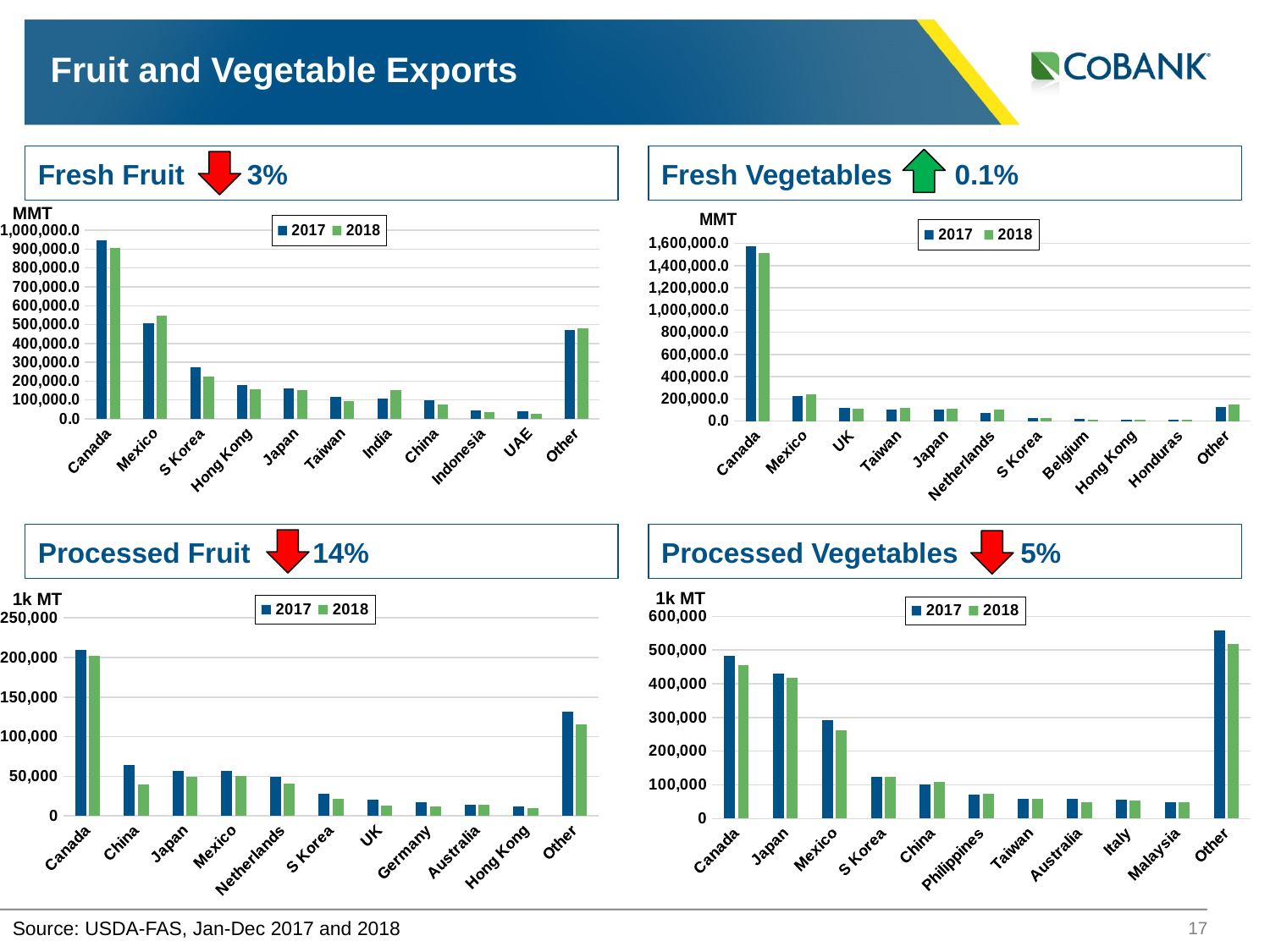
In the Processed Fruit chart, is the 2018 value for China greater or less than 50,000? less In the Processed Vegetables chart, which category has the highest value in 2017? Other In the Processed Fruit chart, which is larger for China: the 2017 value or the 2018 value? 2017 In the Processed Vegetables chart, is the 2017 value for Canada greater or less than 500,000? less How many series does the legend of the Fresh Vegetables chart list? 2 How many categories are shown on the x axis of the Fresh Fruit chart? 11 What kind of chart is the Processed Fruit chart? bar chart In the Fresh Fruit chart, which country has the highest export value in 2017? Canada In the Fresh Fruit chart, is the 2018 value for Mexico greater or less than 500,000.0? greater What percentage change is shown in the title box of the Processed Fruit chart? 14% In the Fresh Vegetables chart, which country has the highest export value in 2018? Canada